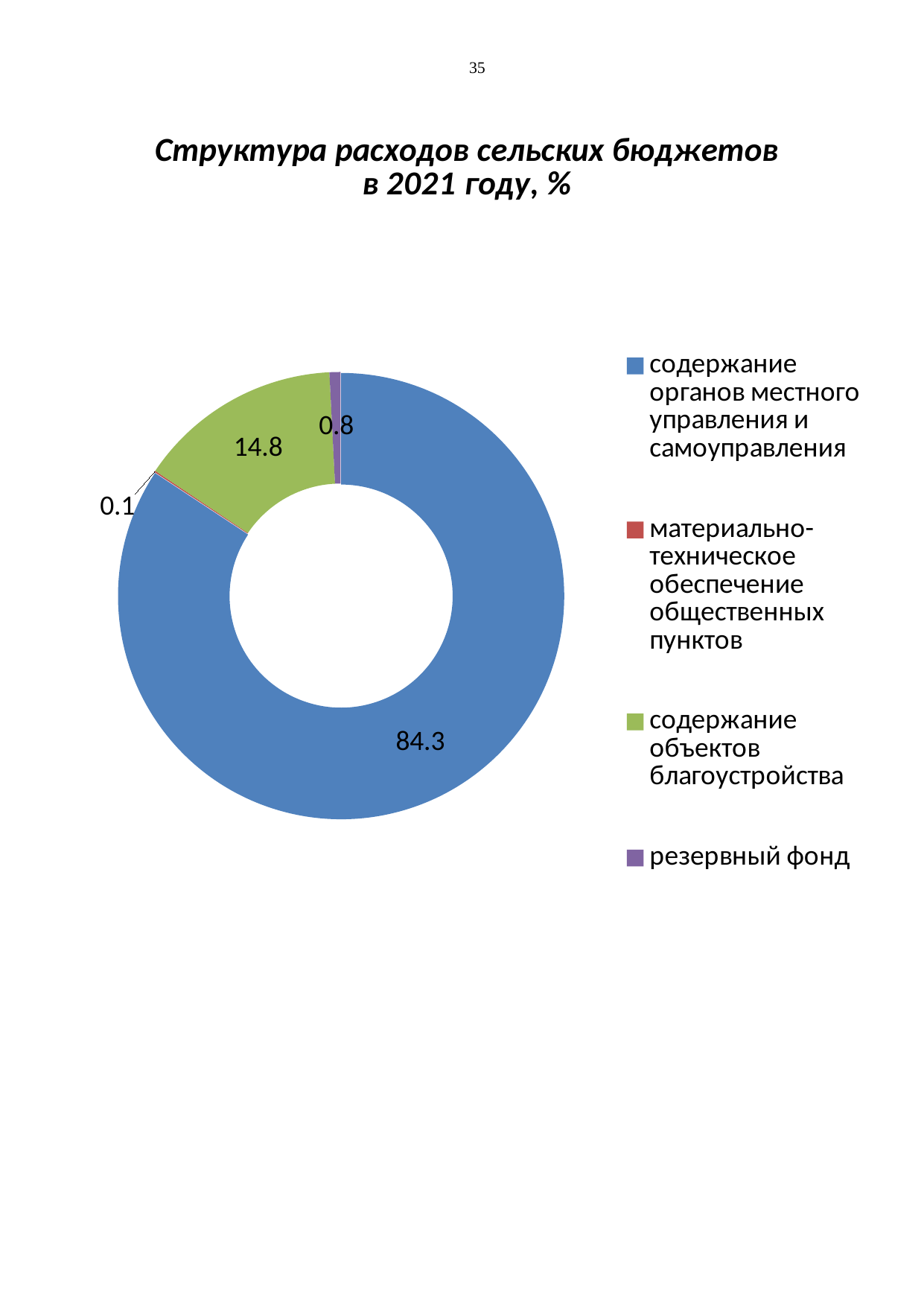
Какова доля расходов на резервный фонд? 0.8 Какая статья расходов имеет наибольшую долю? содержание органов местного управления и самоуправления Как называется диаграмма на слайде? Структура расходов сельских бюджетов в 2021 году, % Какова доля расходов на содержание органов местного управления и самоуправления? 84.3 Какова доля расходов на материально-техническое обеспечение общественных пунктов? 0.1 Какая статья расходов имеет наименьшую долю? материально-техническое обеспечение общественных пунктов Какой тип диаграммы показан на слайде? кольцевая диаграмма Что больше: доля резервного фонда или доля материально-технического обеспечения общественных пунктов? резервный фонд На сколько доля содержания органов местного управления и самоуправления больше доли содержания объектов благоустройства? 69.5 Какова доля расходов на содержание объектов благоустройства? 14.8 Сколько категорий расходов показано на диаграмме? 4 Каким цветом на диаграмме обозначено содержание объектов благоустройства? зелёным